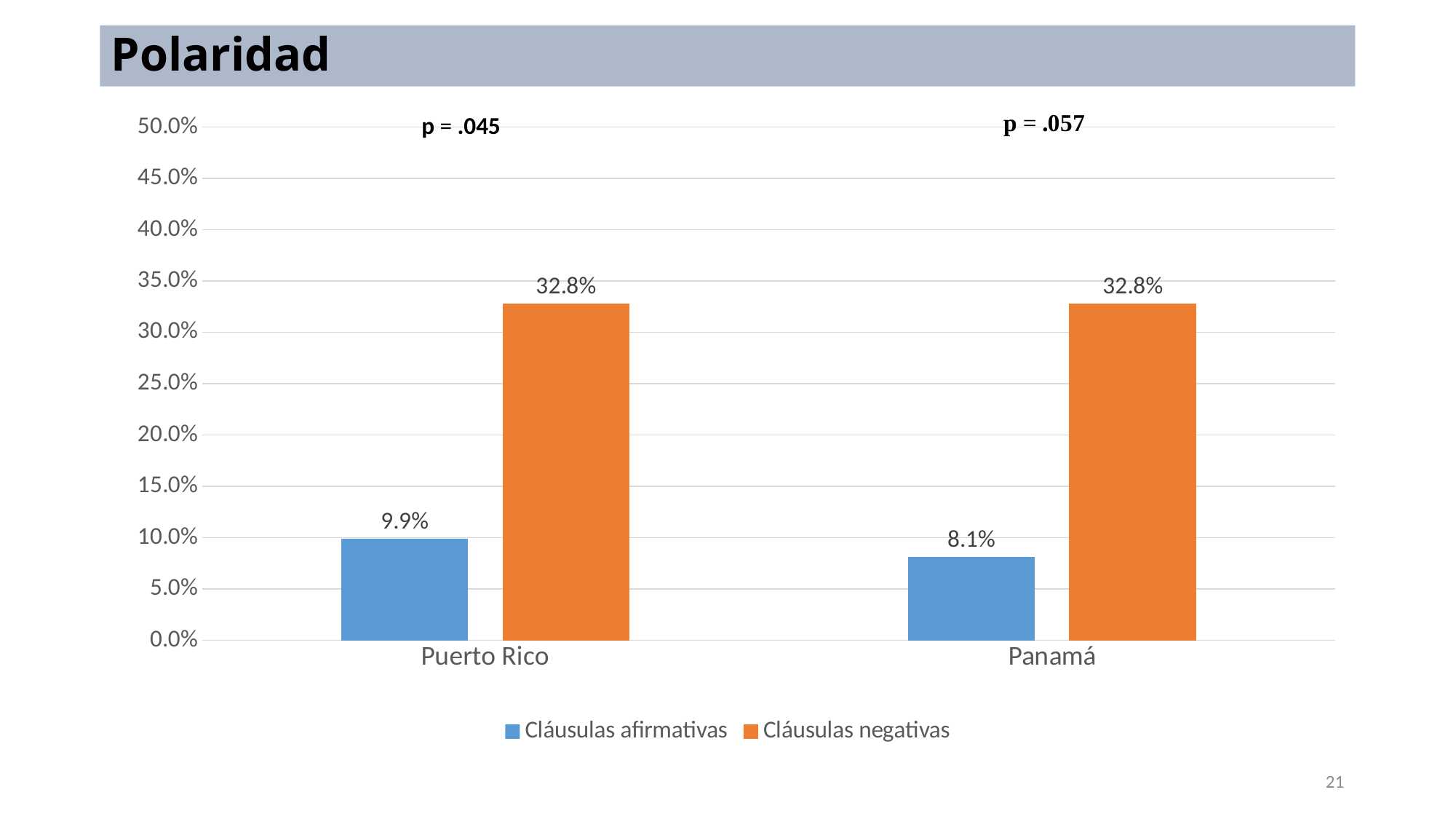
How many series does the legend list? 2 In Panamá, which is larger: Cláusulas afirmativas or Cláusulas negativas? Cláusulas negativas What is the value for Cláusulas negativas in Panamá? 32.8% Which category has the lowest value for Cláusulas afirmativas? Panamá What p value is shown above the Puerto Rico bars? p = .045 What is the value for Cláusulas afirmativas in Puerto Rico? 9.9% What is the difference between Cláusulas afirmativas in Puerto Rico and in Panamá? 1.8% What kind of chart is shown on the slide? Bar chart What is the difference between Cláusulas negativas and Cláusulas afirmativas in Puerto Rico? 22.9% What is the value for Cláusulas negativas in Puerto Rico? 32.8% How many categories are shown on the x axis? 2 What is the value for Cláusulas afirmativas in Panamá? 8.1%